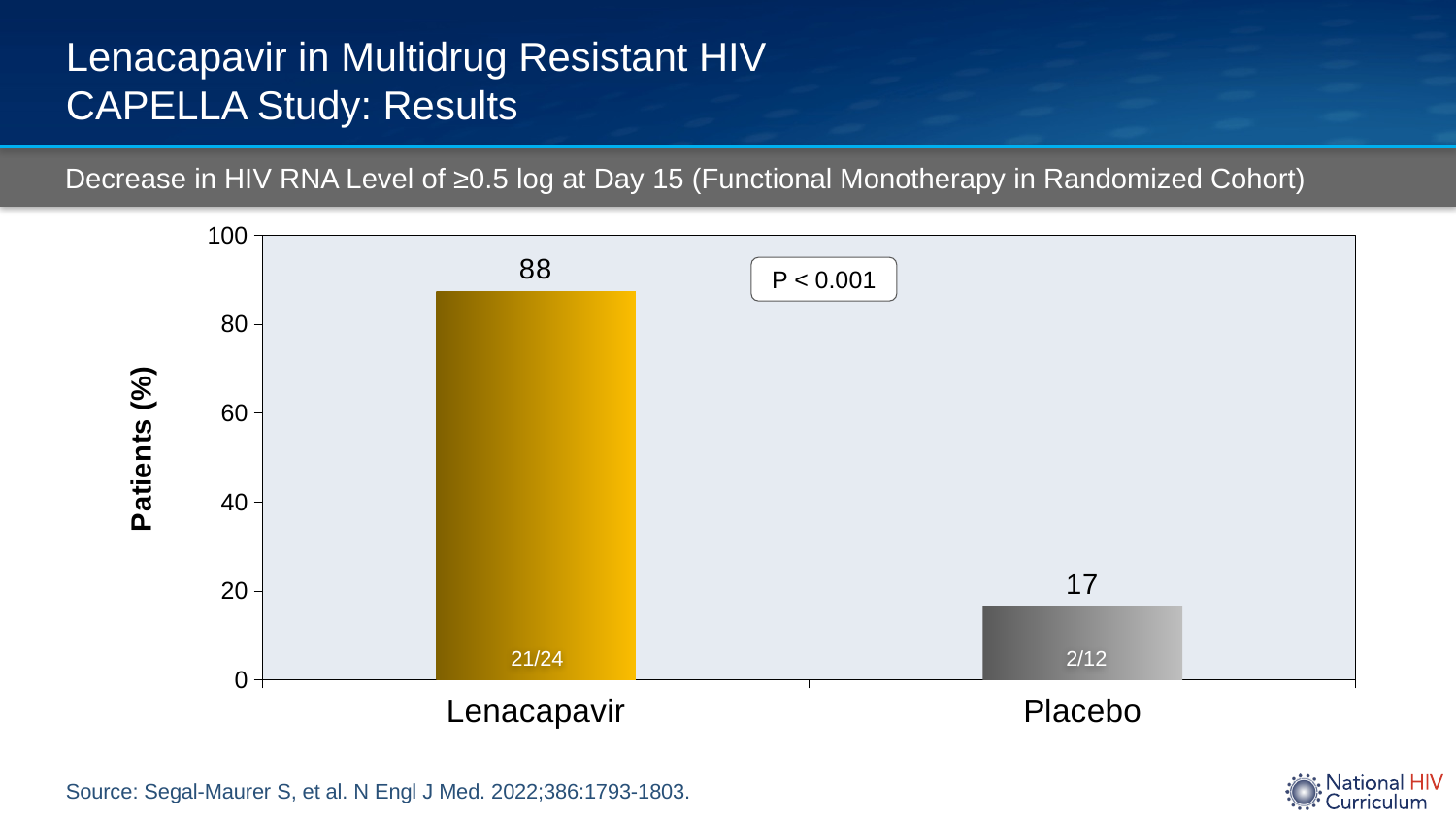
What fraction of patients is printed inside the Lenacapavir bar? 21/24 What is the value for Placebo? 17 What is the value for Lenacapavir? 88 How many categories are shown on the x axis? 2 Which is larger, the value for Lenacapavir or the value for Placebo? Lenacapavir What fraction of patients is printed inside the Placebo bar? 2/12 Which category has the lowest value? Placebo What is the y-axis label of the chart? Patients (%) Which category has the highest value? Lenacapavir What kind of chart is shown? bar chart What is the difference between the Lenacapavir and Placebo values? 71 Is the value for Placebo greater or less than 20? less